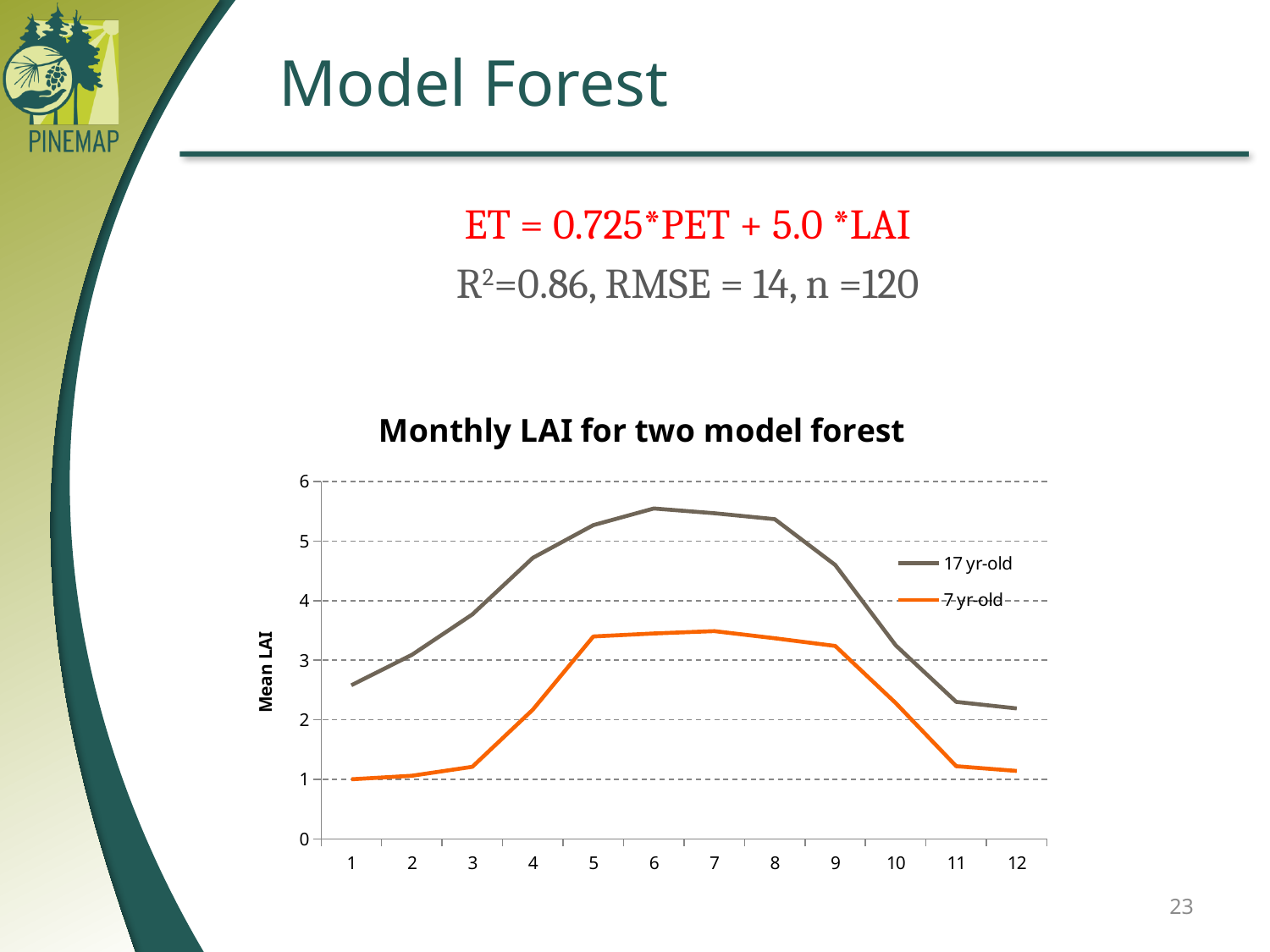
What kind of chart is shown on the slide? line chart How many series does the chart legend list? 2 Is the value for the 17 yr-old series at month 6 greater or less than 5? greater Is the value for the 17 yr-old series at month 3 greater or less than 4? less What is the title of the chart? Monthly LAI for two model forest Is the value for the 7 yr-old series at month 7 greater or less than 3? greater Does the 17 yr-old series rise or fall from month 9 to month 12? fall What is the label of the y axis? Mean LAI How many months are plotted along the x axis of the chart? 12 At month 6, which series has the higher Mean LAI, 17 yr-old or 7 yr-old? 17 yr-old